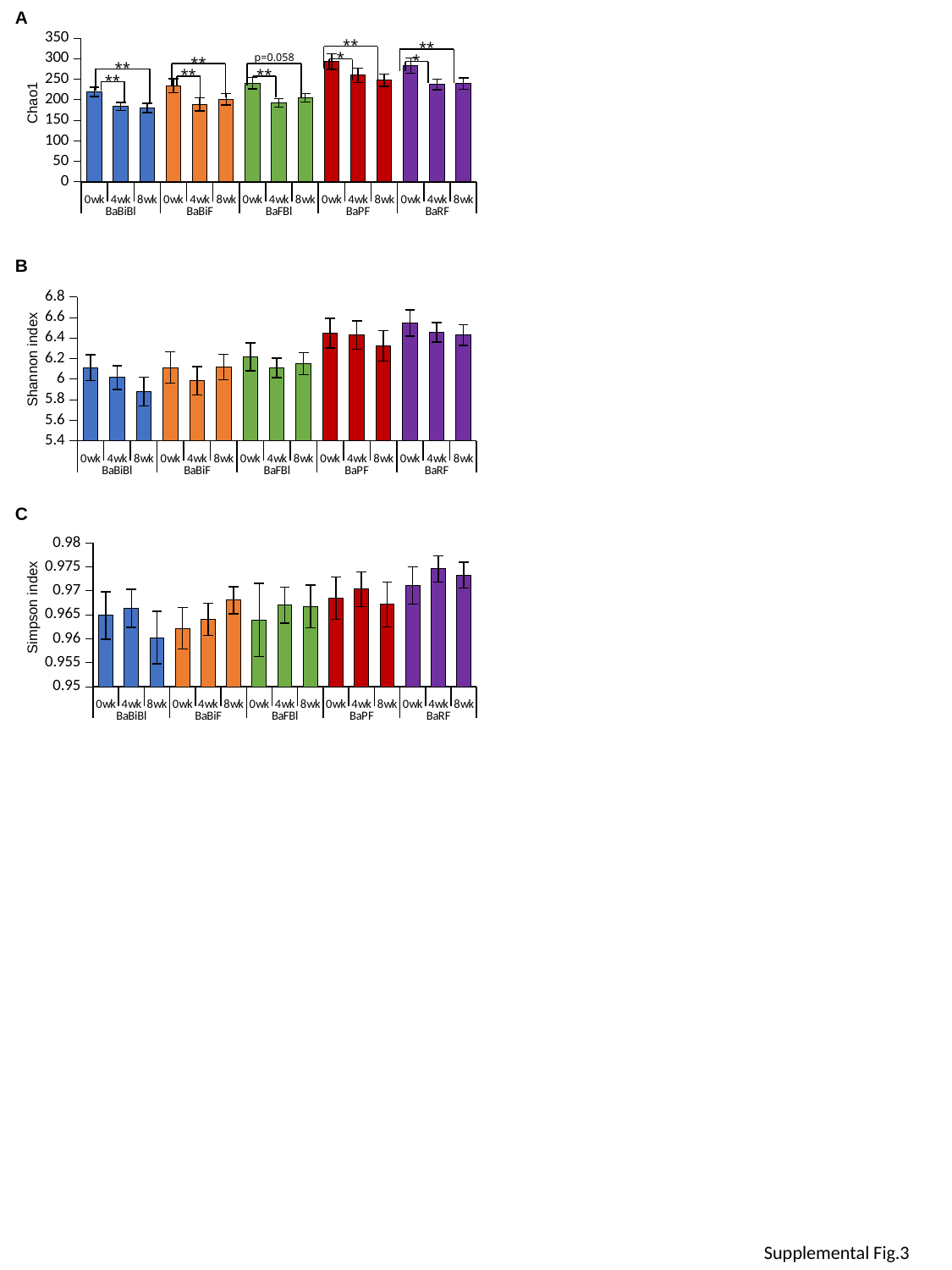
In chart A (Chao1), is the value for BaPF at 0wk greater or less than 250? greater In chart A (Chao1), do the BaBiBl values rise or fall from 0wk to 8wk? fall In chart A (Chao1), how many diet groups are labelled on the x axis? 5 What is the y-axis label of chart C? Simpson index What kind of chart is chart A (Chao1)? bar chart In chart A (Chao1), how many bars are plotted in total? 15 In chart C (Simpson index), is the value for BaRF at 4wk greater or less than 0.97? greater In chart A (Chao1), which is larger: BaPF at 0wk or BaBiBl at 0wk? BaPF at 0wk In chart B (Shannon index), which bar is the lowest? BaBiBl 8wk In chart A (Chao1), is the value for BaBiBl at 4wk greater or less than 200? less In chart B (Shannon index), which bar is the highest? BaRF 0wk